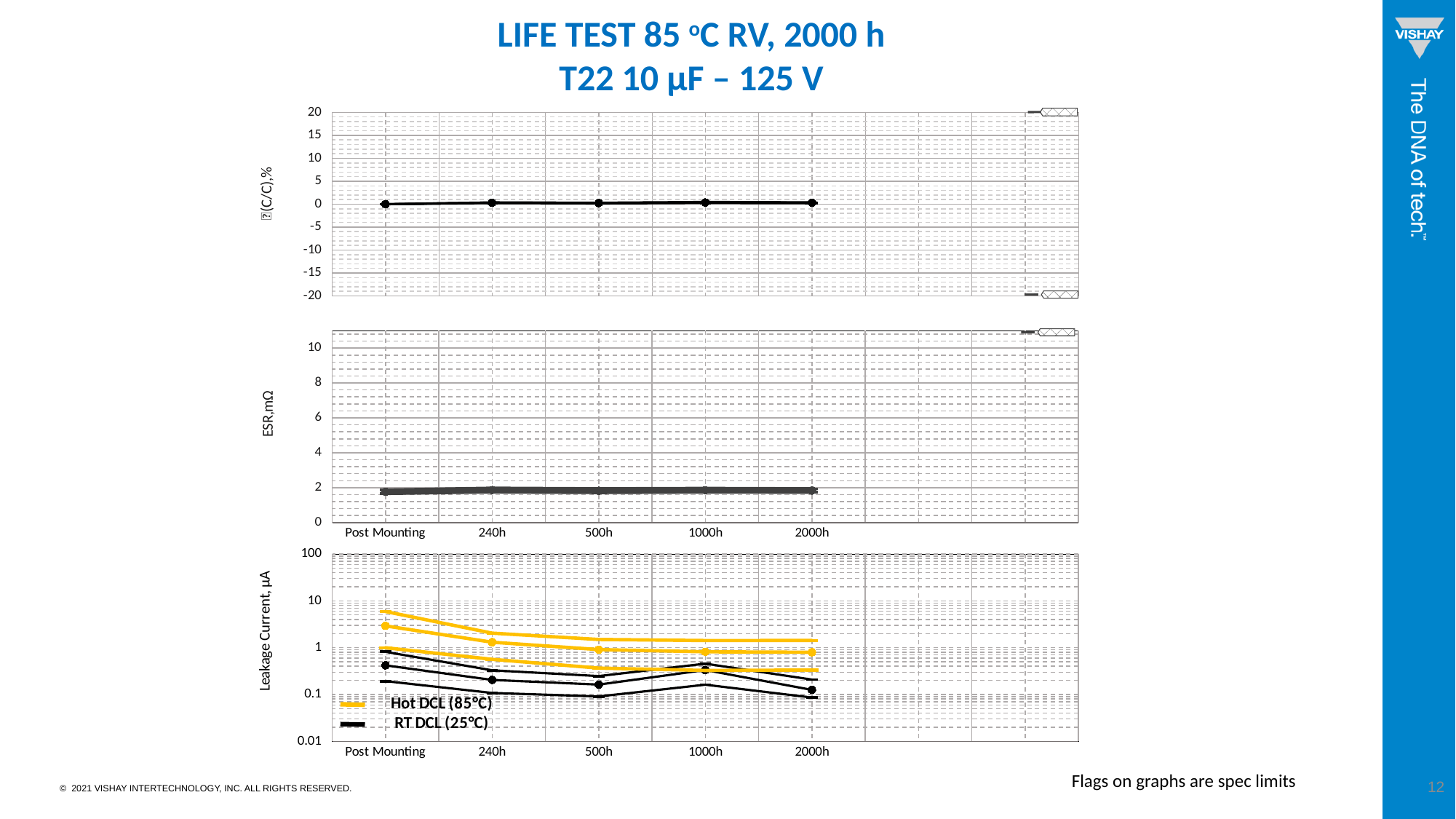
In the bottom chart (Leakage Current), which series is higher at Post Mounting, Hot DCL (85°C) or RT DCL (25°C)? Hot DCL (85°C) In the bottom chart (Leakage Current), what colour is the Hot DCL (85°C) series? yellow What is the y-axis label of the middle chart? ESR,mΩ What kind of chart is the bottom chart (Leakage Current)? line chart In the top chart (capacitance change), is the value at 1000h greater or less than 5? less In the bottom chart (Leakage Current), is the Hot DCL (85°C) value at Post Mounting greater or less than 1? greater In the bottom chart (Leakage Current), at which time point is the Hot DCL (85°C) value highest? Post Mounting How many time points are shown on the x axis of the middle chart (ESR)? 5 In the middle chart (ESR), is the value at 2000h greater or less than 4? less In the bottom chart (Leakage Current), does the Hot DCL (85°C) series rise or fall from Post Mounting to 2000h? fall How many series does the legend of the bottom chart (Leakage Current) list? 2